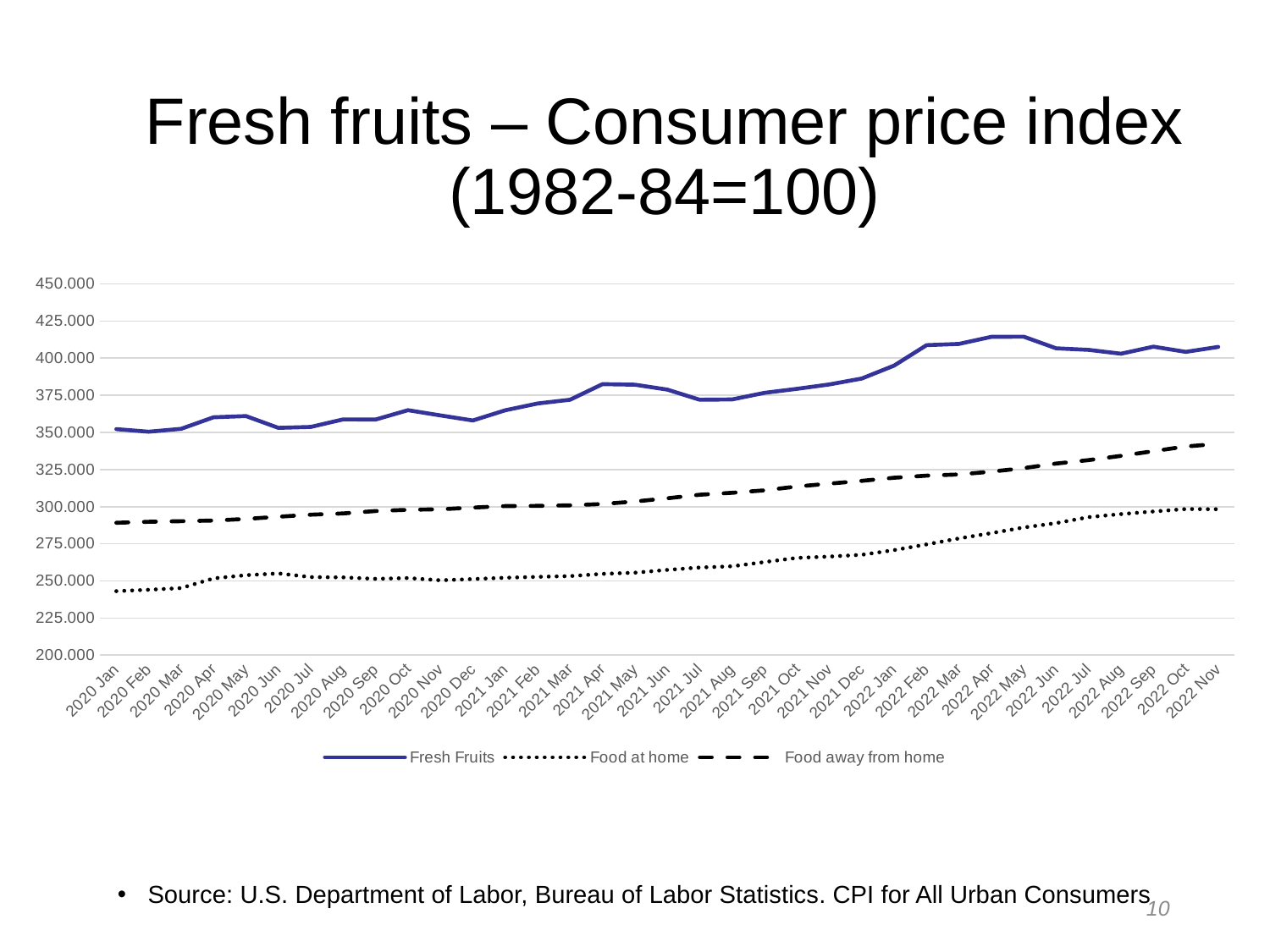
How many series does the legend list? 3 Which series has the lowest values across the whole period? Food at home Does the Food away from home series rise or fall from 2020 Jan to 2022 Nov? rise Is the value for Fresh Fruits in 2022 Apr greater or less than 400.000? greater How many monthly data points are plotted along the x axis, from 2020 Jan to 2022 Nov? 35 Is the value for Food away from home in 2022 Nov greater or less than 325.000? greater Which series has the highest values across the whole period? Fresh Fruits Which series is drawn with a dashed line in the legend? Food away from home What kind of chart is shown on the slide? Line chart Is the value for Food at home in 2020 Jan greater or less than 250.000? less Which is larger in 2021 Jan, the value for Fresh Fruits or the value for Food at home? Fresh Fruits